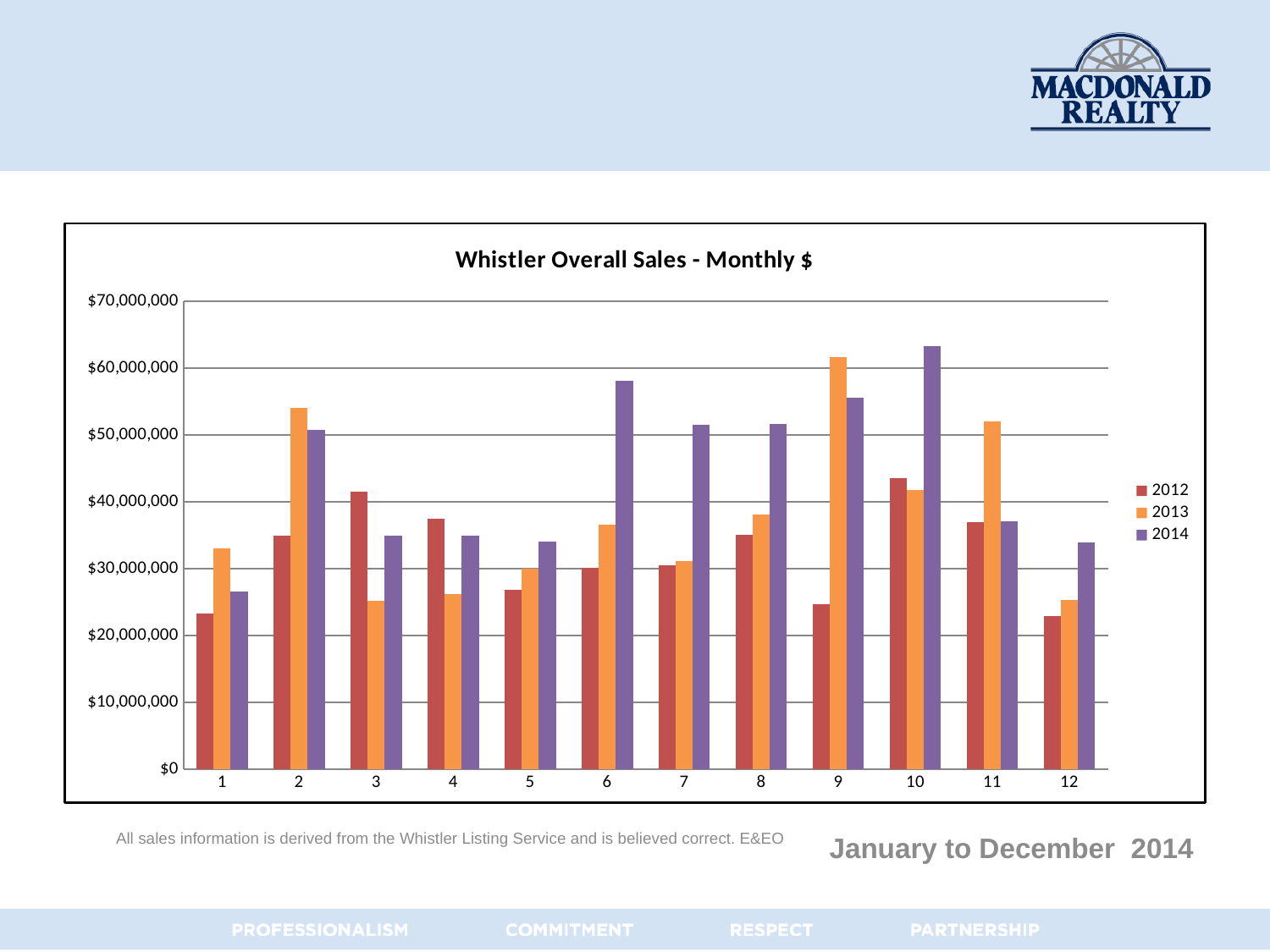
In month 9, which series has the larger value, 2013 or 2014? 2013 In which month is the 2013 value highest? 9 What is the title of the chart? Whistler Overall Sales - Monthly $ In which month is the 2014 value lowest? 1 In month 6, which series has the larger value, 2012 or 2014? 2014 Is the 2014 value for month 6 greater or less than $50,000,000? greater Is the 2012 value for month 1 greater or less than $30,000,000? less What type of chart is shown on the slide? Bar chart Is the 2013 value for month 9 greater or less than $60,000,000? greater How many series does the legend list? 3 In which month is the 2014 value highest? 10 How many months (categories) are shown on the x axis? 12